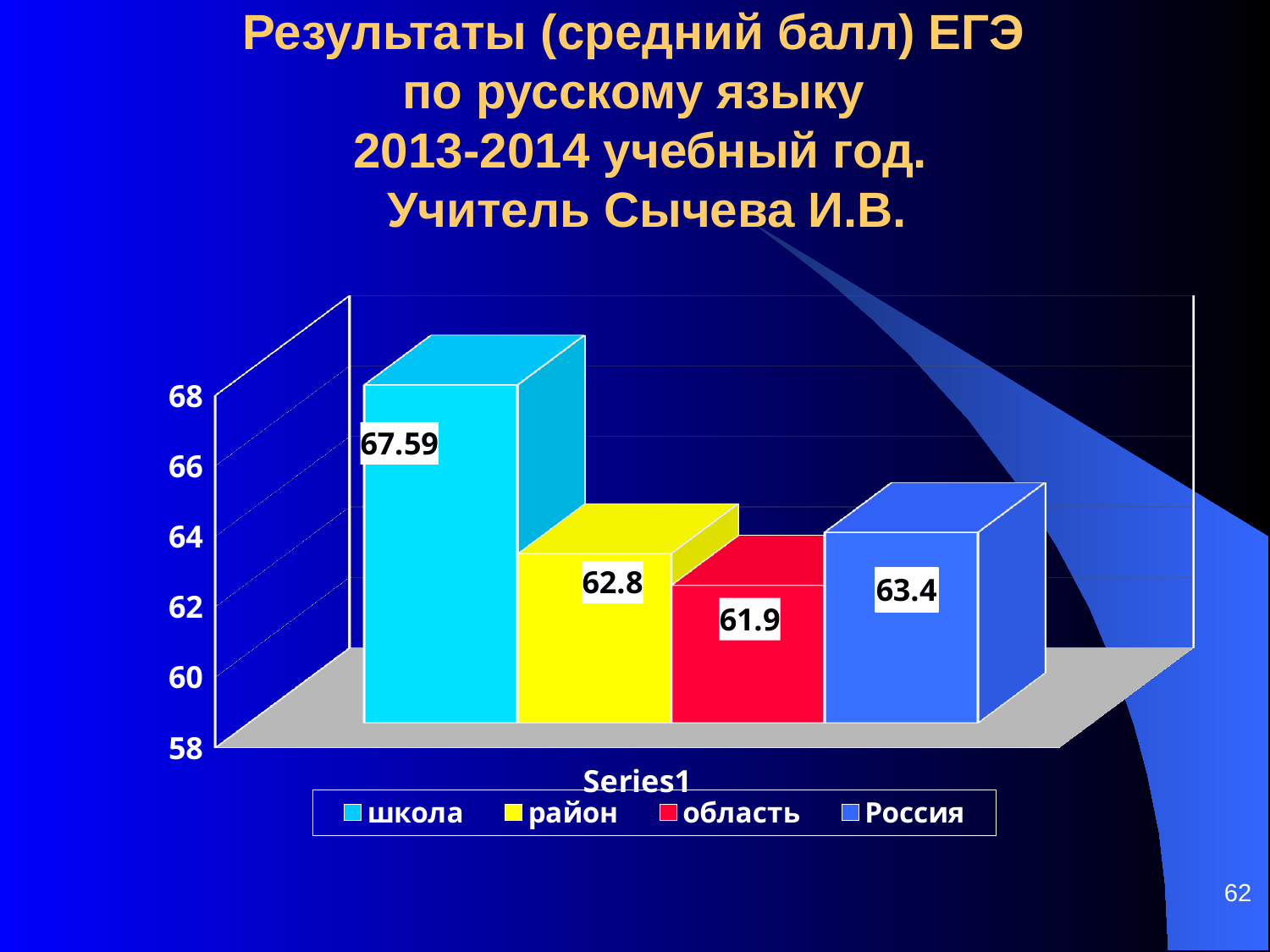
What is the value for Россия? 63.4 What kind of chart is shown on the slide? bar chart Which is larger, the value for район or the value for Россия? Россия What is the value for школа? 67.59 What is the value for область? 61.9 What is the difference between the values for район and область? 0.9 Which category has the lowest value? область Which category has the highest value? школа What is the value for район? 62.8 How many bars are shown in the chart? 4 What is the difference between the values for школа and Россия? 4.19 How many entries does the legend list? 4